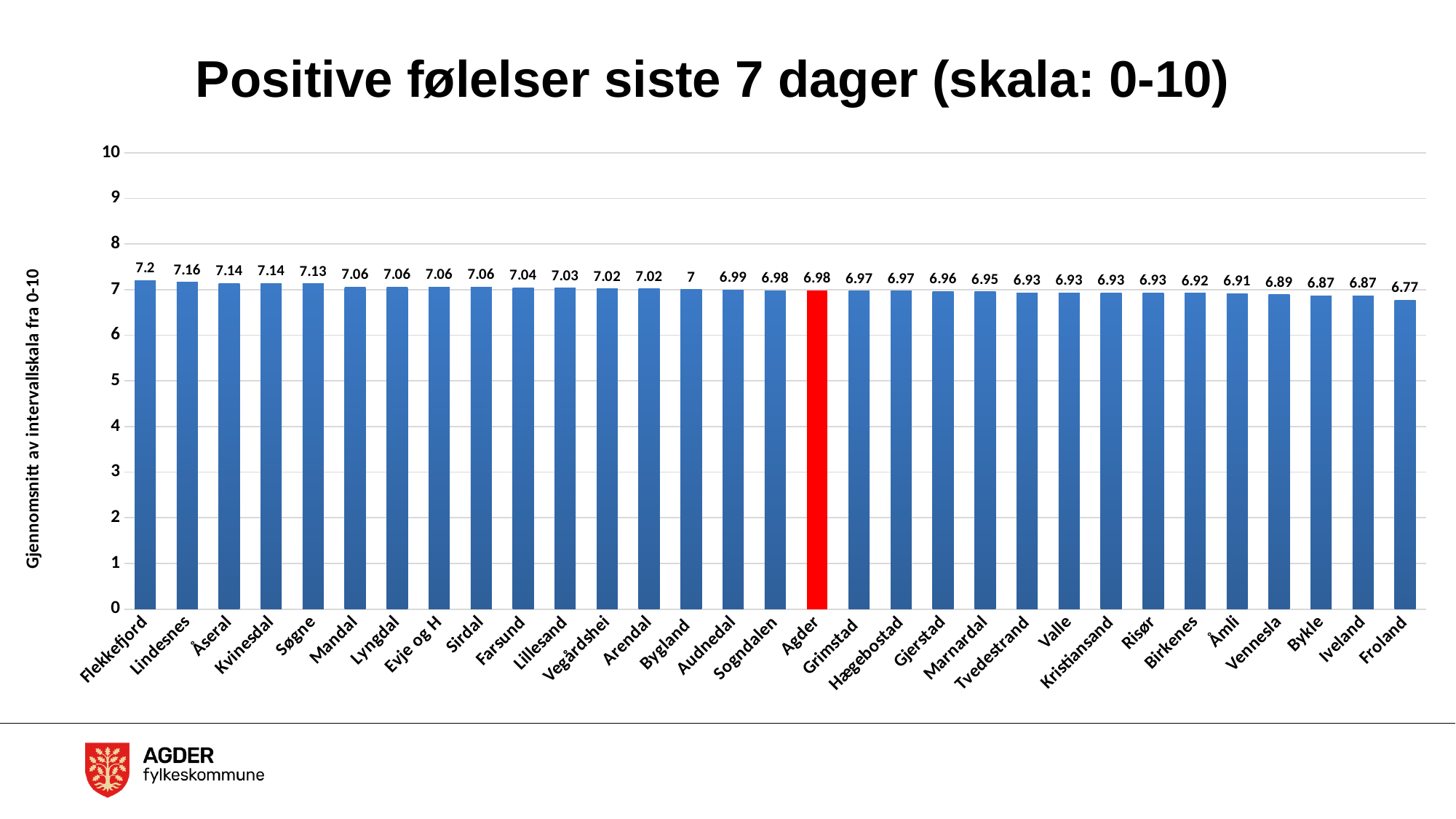
What is the value for Kristiansand? 6.93 Is the value for Froland greater or less than 8? less How many categories are shown on the x axis? 31 What is the value for Agder? 6.98 What is the value for Flekkefjord? 7.2 What is the difference between the values for Flekkefjord and Froland? 0.43 Which category has the highest value? Flekkefjord What is the value for Bygland? 7 Which category has the lowest value? Froland Which is larger, the value for Lindesnes or the value for Vennesla? Lindesnes Which category is shown with a red bar? Agder What kind of chart is shown on the slide? bar chart